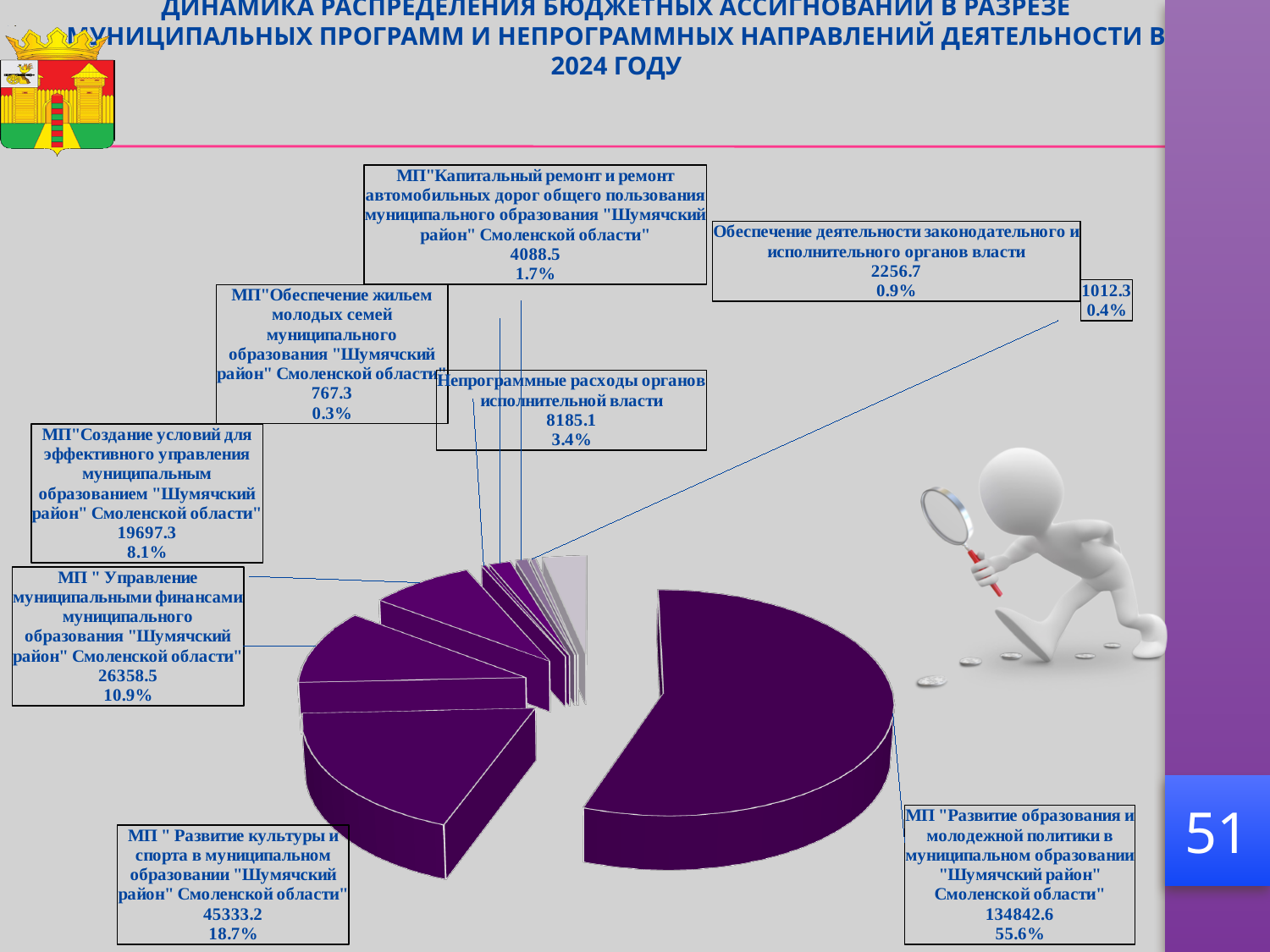
What type of chart is shown on the slide? pie chart What is the value for МП "Развитие образования и молодежной политики"? 134842.6 What is the difference between the values for МП "Развитие культуры и спорта" and МП "Управление муниципальными финансами"? 18974.7 What is the value for Непрограммные расходы органов исполнительной власти? 8185.1 Which named category has the smallest value? МП "Обеспечение жильем молодых семей" What percentage is shown for МП "Обеспечение жильем молодых семей"? 0.3% What year does the chart title refer to? 2024 What is the value for МП "Развитие культуры и спорта"? 45333.2 What percentage is shown for МП "Управление муниципальными финансами"? 10.9% Which category has the largest share of the pie? МП "Развитие образования и молодежной политики" What share of the pie does МП "Развитие образования и молодежной политики" represent? 55.6% Which is larger: the value for МП "Создание условий для эффективного управления" or Непрограммные расходы органов исполнительной власти? МП "Создание условий для эффективного управления"